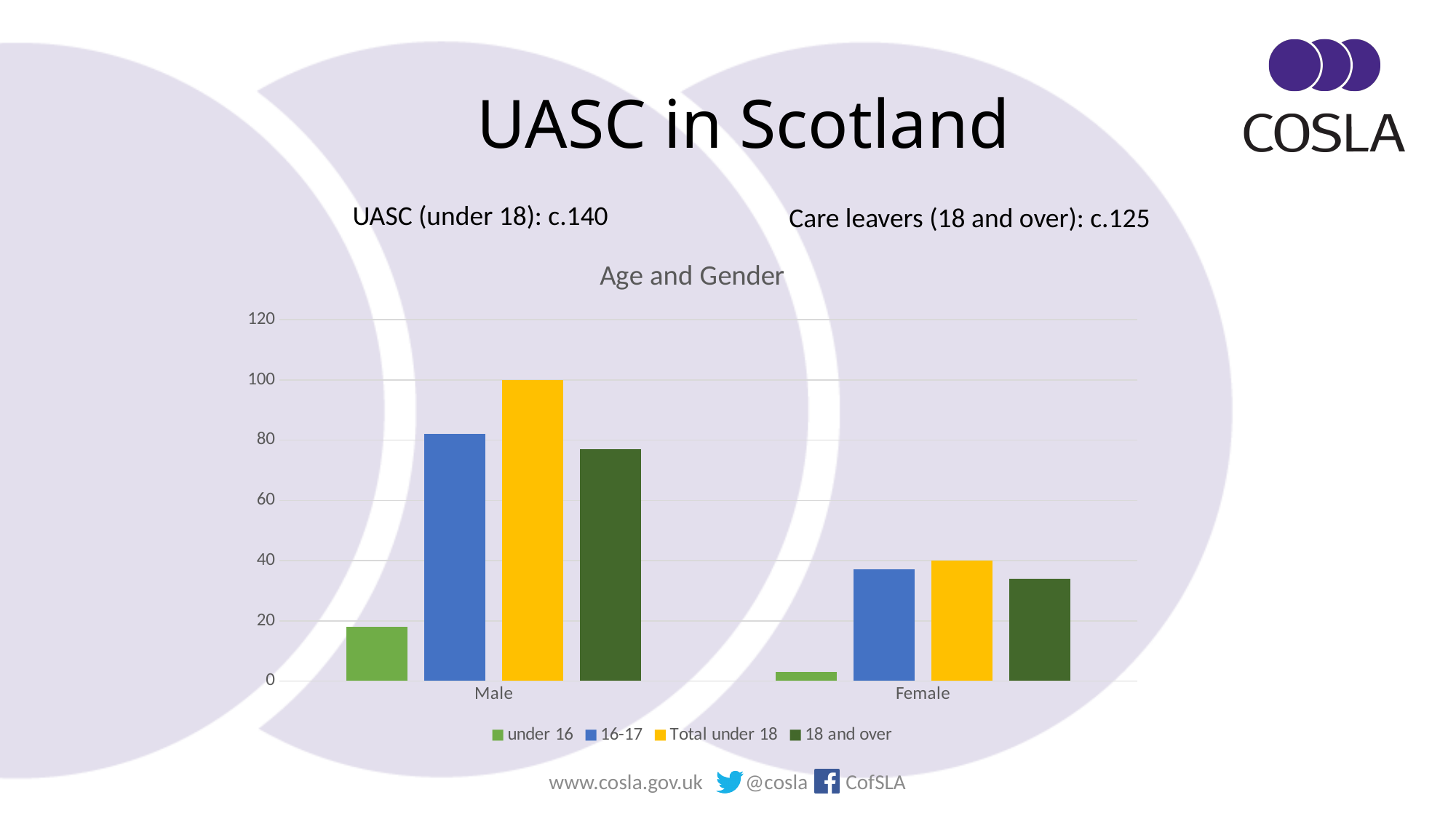
How many series does the legend of the Age and Gender chart list? 4 What is the value of Total under 18 for Male? 100 Is the value for 16-17 in the Male category greater or less than 60? greater For the Male category, which is larger: 16-17 or 18 and over? 16-17 Which series has the lowest value in the Female category? under 16 What is the title of the chart? Age and Gender What is the value of Total under 18 for Female? 40 Is the value for under 16 in the Male category greater or less than 20? less How many categories are shown on the x axis of the Age and Gender chart? 2 Is the value for 16-17 in the Female category greater or less than 20? greater Which category, Male or Female, has the higher Total under 18 value? Male What kind of chart is shown on the slide? bar chart